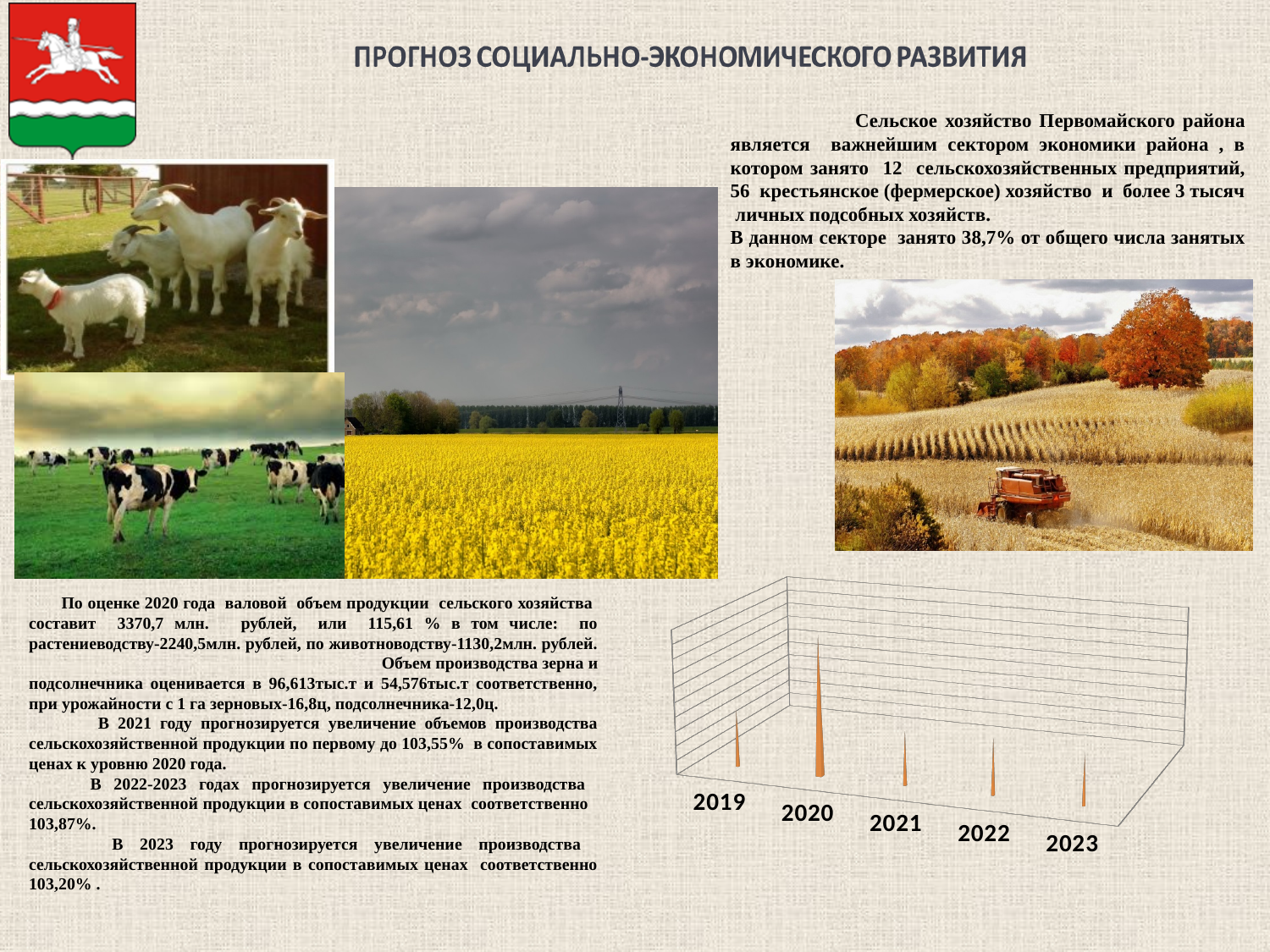
What kind of chart is shown at the bottom right of the slide? bar chart Which year has the highest value in the chart? 2020 What is the last year shown on the x axis of the chart? 2023 Which is larger in the chart, the value for 2020 or the value for 2023? 2020 Which is larger in the chart, the value for 2019 or the value for 2020? 2020 How many categories (years) are shown on the x axis of the chart? 5 Which is larger in the chart, the value for 2020 or the value for 2021? 2020 What is the first year shown on the x axis of the chart? 2019